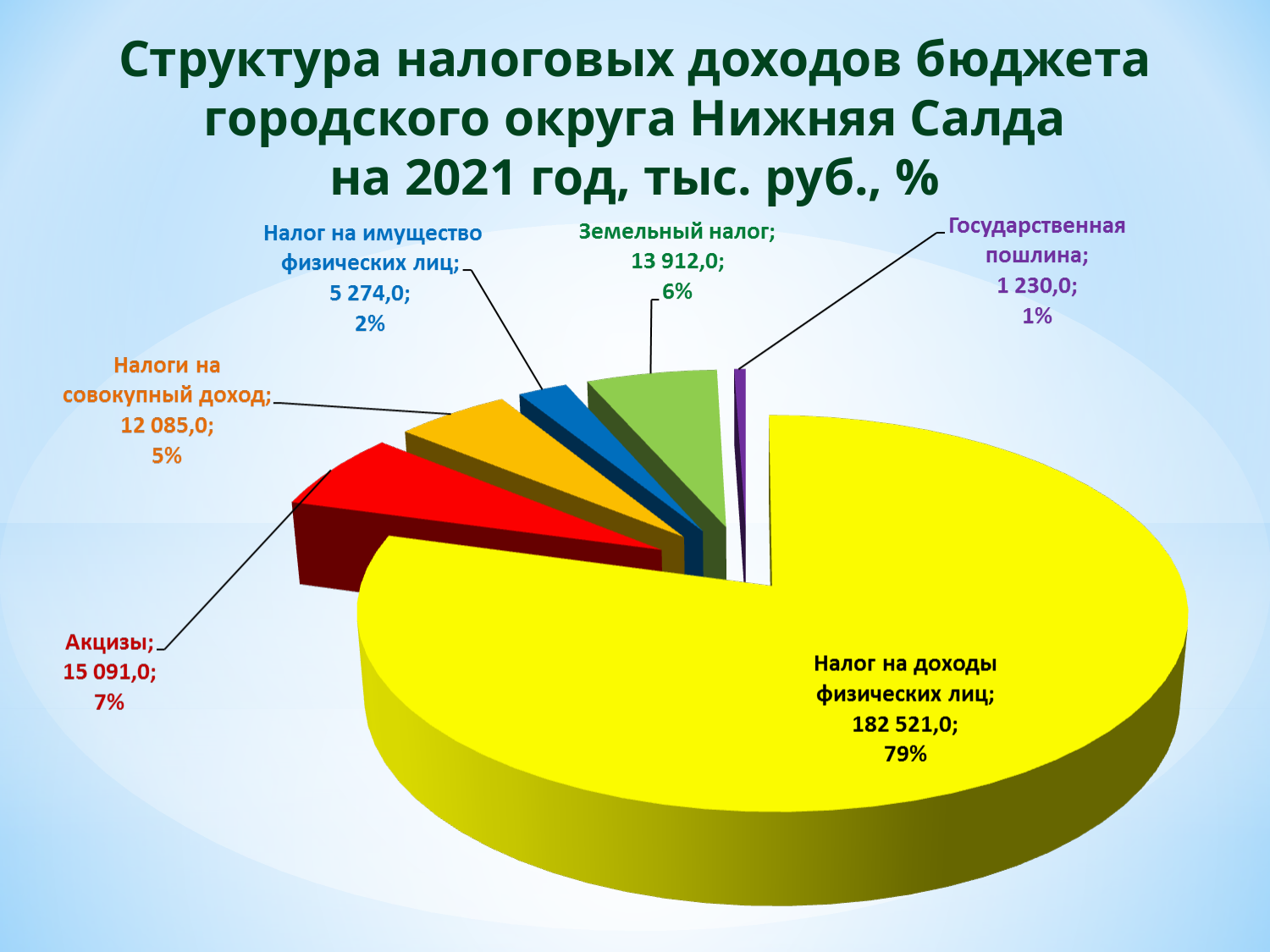
What is the value for Налог на доходы физических лиц? 182 521,0 Which category has the smallest slice of the pie? Государственная пошлина How many slices does the pie chart have? 6 Which is larger: Акцизы or Налоги на совокупный доход? Акцизы What is the value for Налог на имущество физических лиц? 5 274,0 What share of the pie does Государственная пошлина represent? 1% Which category has the largest slice of the pie? Налог на доходы физических лиц What colour is the slice for Налог на доходы физических лиц? yellow What share of the pie does Акцизы represent? 7% What is the difference between the values for Земельный налог and Налоги на совокупный доход? 1 827,0 What kind of chart is shown on the slide? pie chart What is the value for Земельный налог? 13 912,0